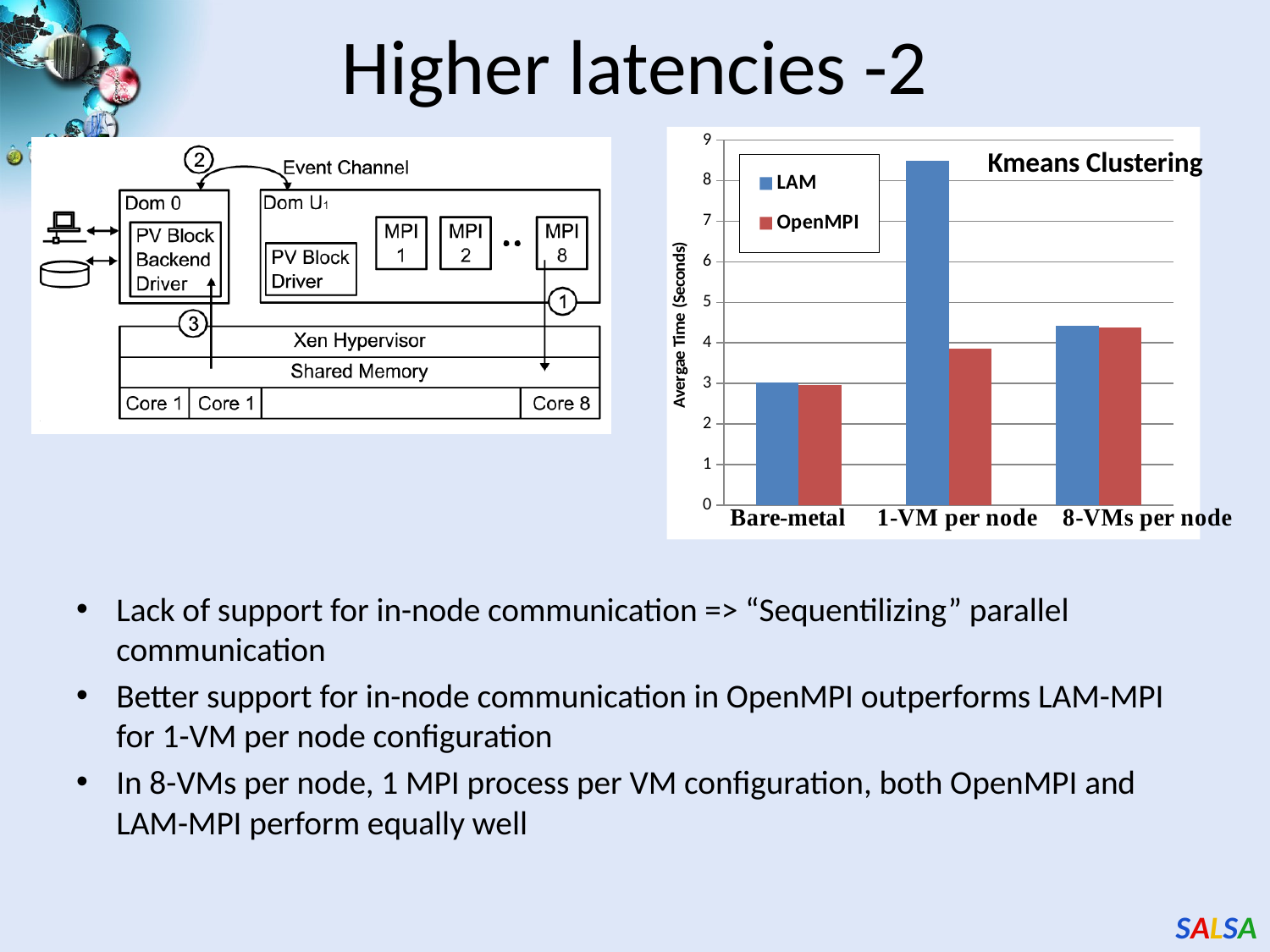
In the Kmeans Clustering chart, is the LAM value for 8-VMs per node greater or less than 4? greater In the Kmeans Clustering chart, for which category is the OpenMPI bar lowest? Bare-metal How many categories are shown on the x axis of the Kmeans Clustering chart? 3 What is the title of the chart on the slide? Kmeans Clustering In the Kmeans Clustering chart, which is larger for 1-VM per node: LAM or OpenMPI? LAM What kind of chart is the Kmeans Clustering chart? bar chart What is the y-axis label of the Kmeans Clustering chart? Avergae Time (Seconds) In the Kmeans Clustering chart, is the LAM value for Bare-metal greater or less than 4? less In the Kmeans Clustering chart, for which category is the LAM bar highest? 1-VM per node In the Kmeans Clustering chart, is the LAM value for 1-VM per node greater or less than 8? greater How many series does the legend of the Kmeans Clustering chart list? 2